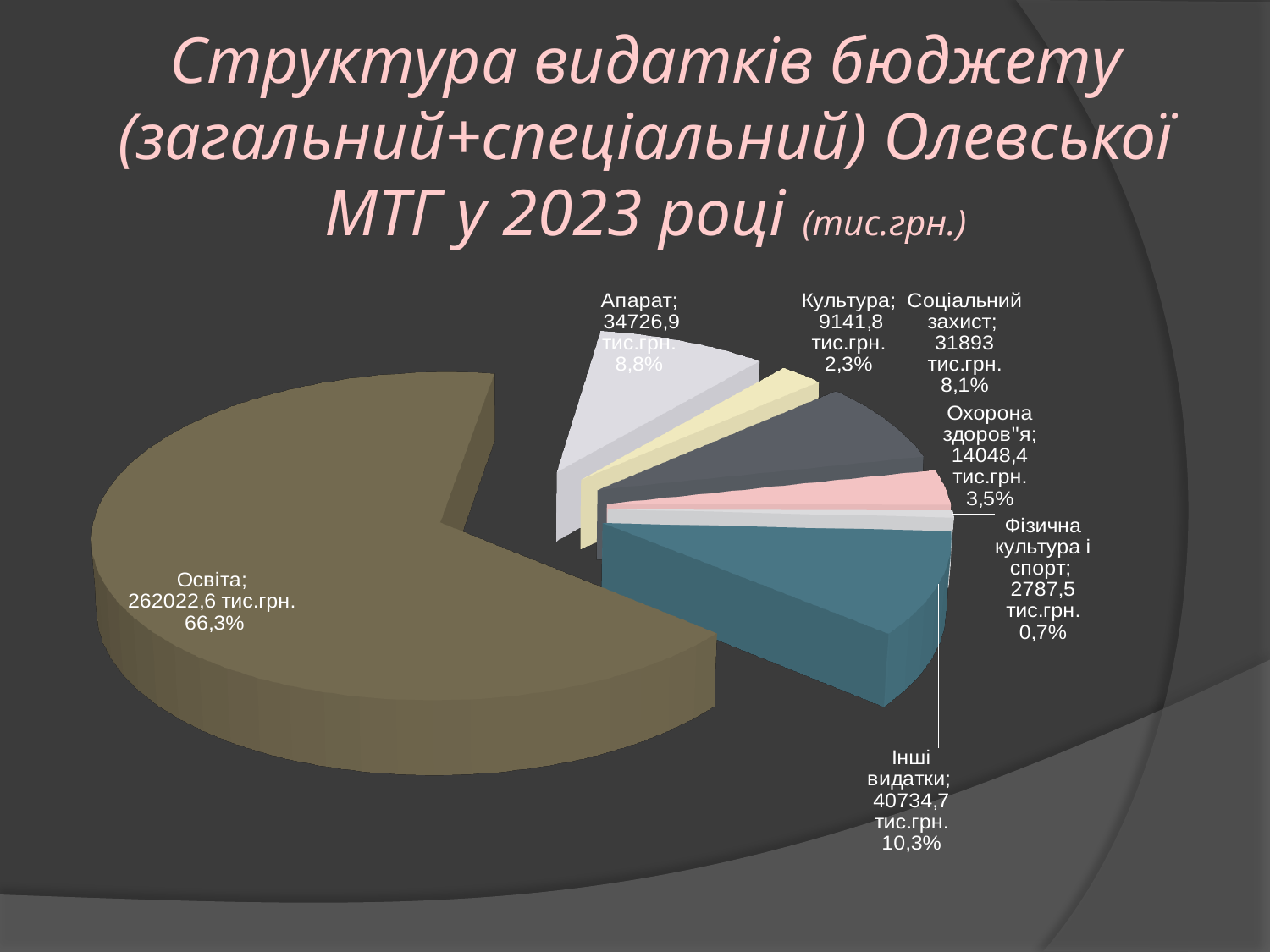
Which is larger, Культура or Охорона здоров"я? Охорона здоров"я What is the value for Апарат? 34726,9 тис.грн. What is the value for Соціальний захист? 31893 тис.грн. What is the difference between the values for Інші видатки and Апарат? 6007,8 тис.грн. What share of the pie does Фізична культура і спорт take? 0,7% What share of the pie does Освіта take? 66,3% What kind of chart is shown on the slide? Pie chart Which category has the smallest slice? Фізична культура і спорт Which category has the largest slice? Освіта What is the value for Освіта? 262022,6 тис.грн. What share of the pie does Інші видатки take? 10,3% How many slices does the pie chart have? 7